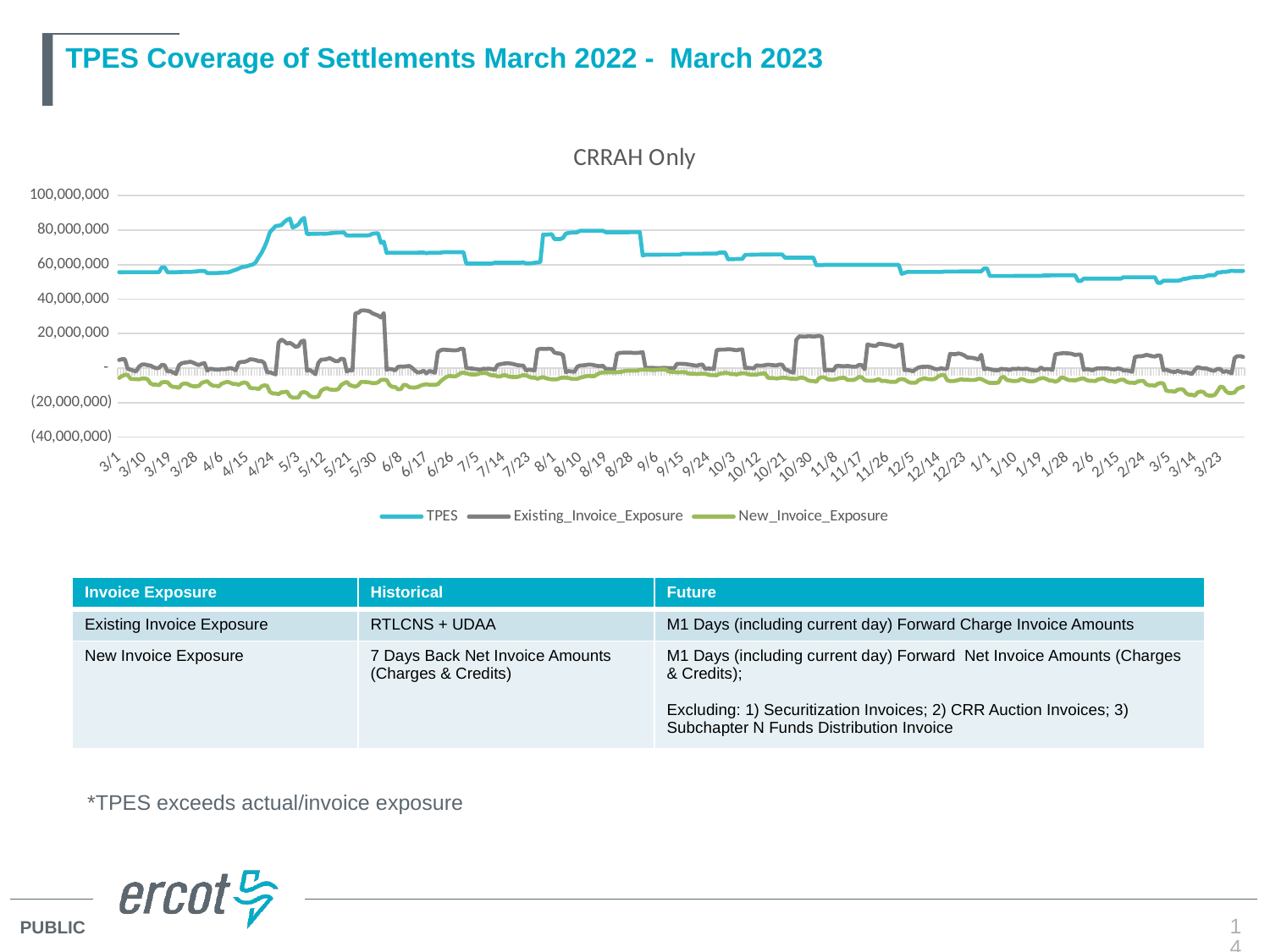
Is the peak value of TPES around 5/3 greater or less than 80,000,000? greater Is the value of TPES on 3/1 greater or less than 40,000,000? greater Is the value of New_Invoice_Exposure around 5/12 greater or less than 0? less Which series is plotted in green? New_Invoice_Exposure What kind of chart is shown on the slide? line chart Which series has the highest values across the whole chart? TPES Does the TPES line generally rise or fall from 9/6 to 3/23? fall On 3/1, which is larger: TPES or Existing_Invoice_Exposure? TPES How many series does the chart legend list? 3 What is the title of the chart? CRRAH Only Which series has the lowest values across the whole chart? New_Invoice_Exposure